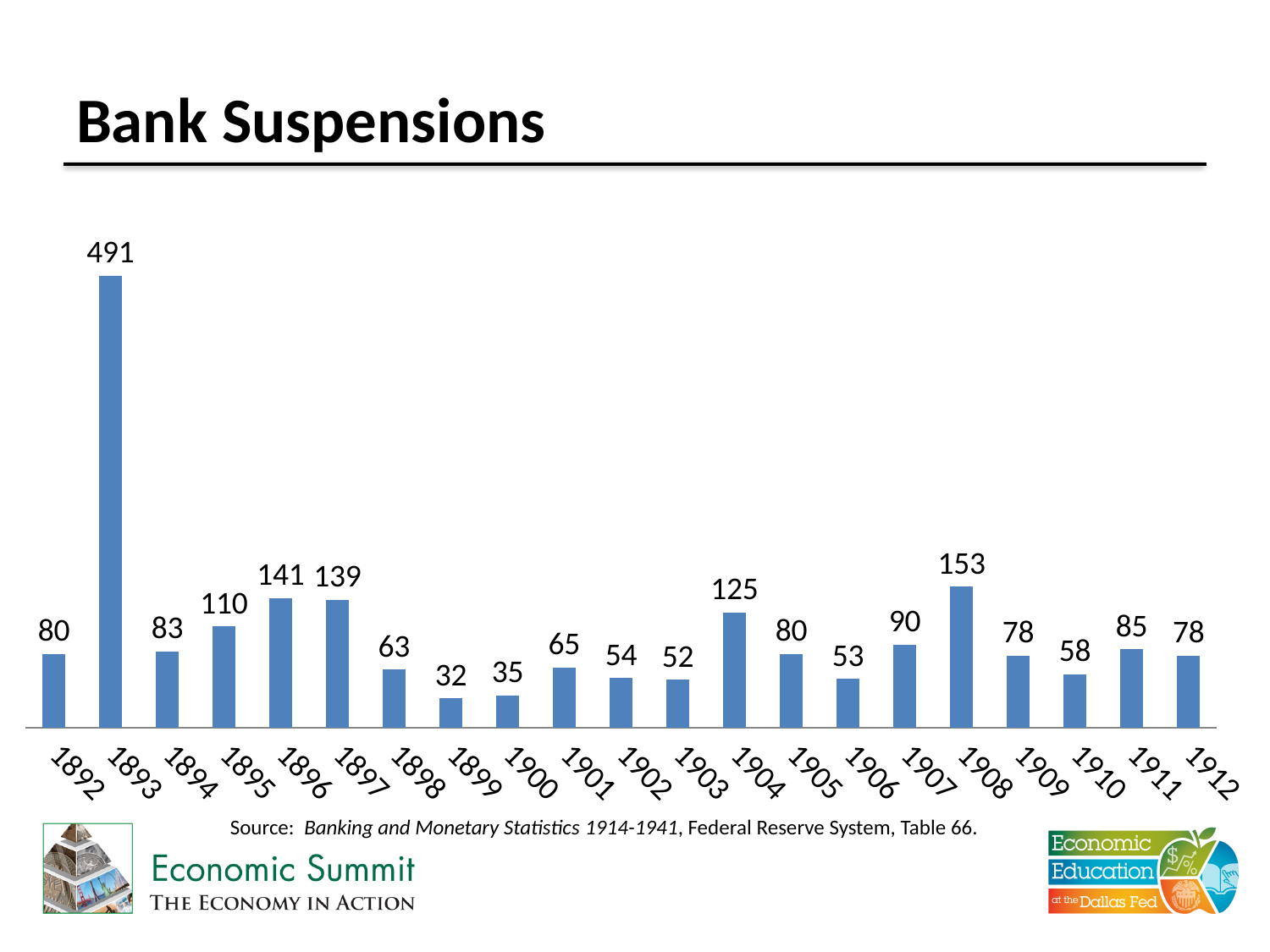
Do the values rise or fall from 1897 to 1899? fall How many years are shown on the x axis? 21 Which year has the highest value? 1893 What is the value for 1899? 32 What is the value for 1908? 153 What is the difference between the values for 1893 and 1908? 338 Which year has the lowest value? 1899 What kind of chart is this? bar chart Which is larger, the value for 1904 or the value for 1907? 1904 What is the title of the chart? Bank Suspensions What is the value for 1893? 491 What is the difference between the values for 1896 and 1897? 2